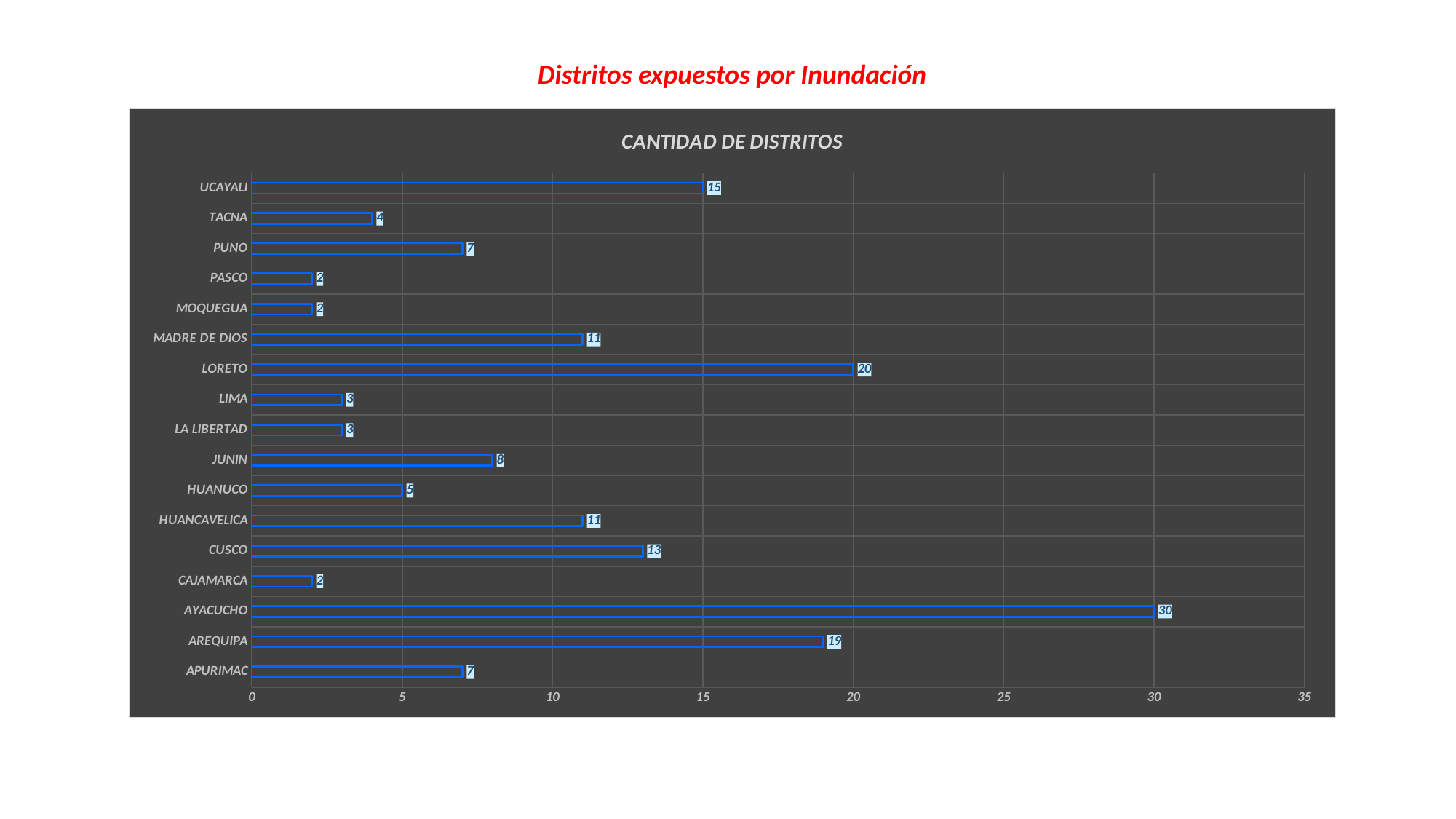
Which is larger, the value for JUNIN or the value for HUANUCO? JUNIN How many categories are shown on the chart? 17 Which is larger, the value for LORETO or the value for AREQUIPA? LORETO What is the title of the chart? CANTIDAD DE DISTRITOS Which category has the highest value? AYACUCHO What is the value for AYACUCHO? 30 Is the value for AYACUCHO greater or less than 25? greater What kind of chart is shown? bar chart What is the difference between the values for AYACUCHO and AREQUIPA? 11 What is the value for MADRE DE DIOS? 11 What is the value for LORETO? 20 What is the difference between the values for UCAYALI and CUSCO? 2